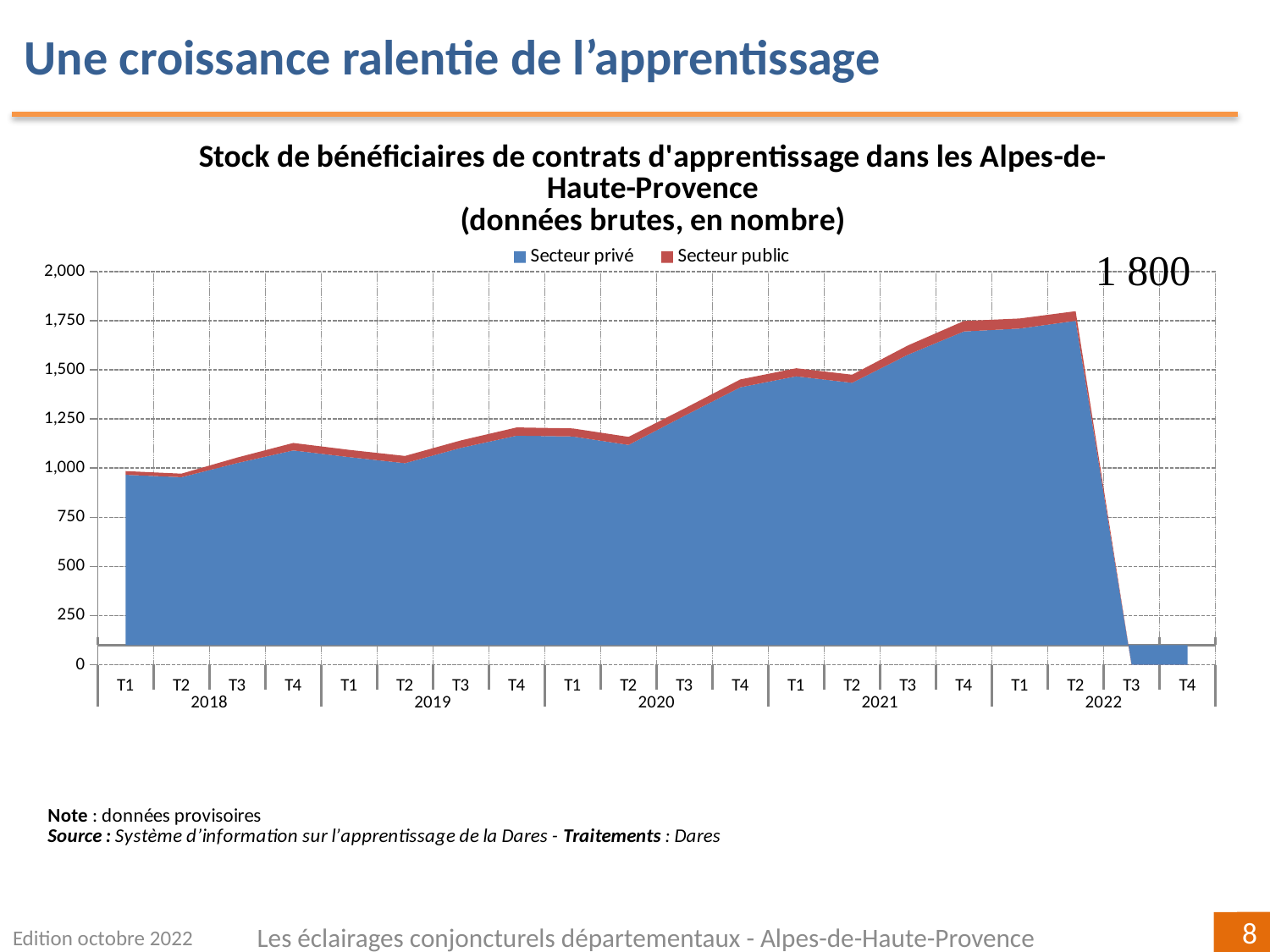
In which quarter does the total stock reach its highest level? T2 2022 Is the total stock in T4 2020 greater or less than 1,250? greater Is the total stock in T4 2018 greater or less than 1,000? greater What are the two series named in the legend? Secteur privé and Secteur public Is the total stock in T2 2022 greater or less than 2,000? less What kind of chart is shown on the slide? Stacked area chart Which series accounts for the larger part of the stock, Secteur privé or Secteur public? Secteur privé Does the total stock of apprenticeship contracts rise or fall between T1 2018 and T2 2022? Rise How many quarterly points are labelled along the x axis? 20 How many years are labelled along the x axis? 5 How many series does the legend list? 2